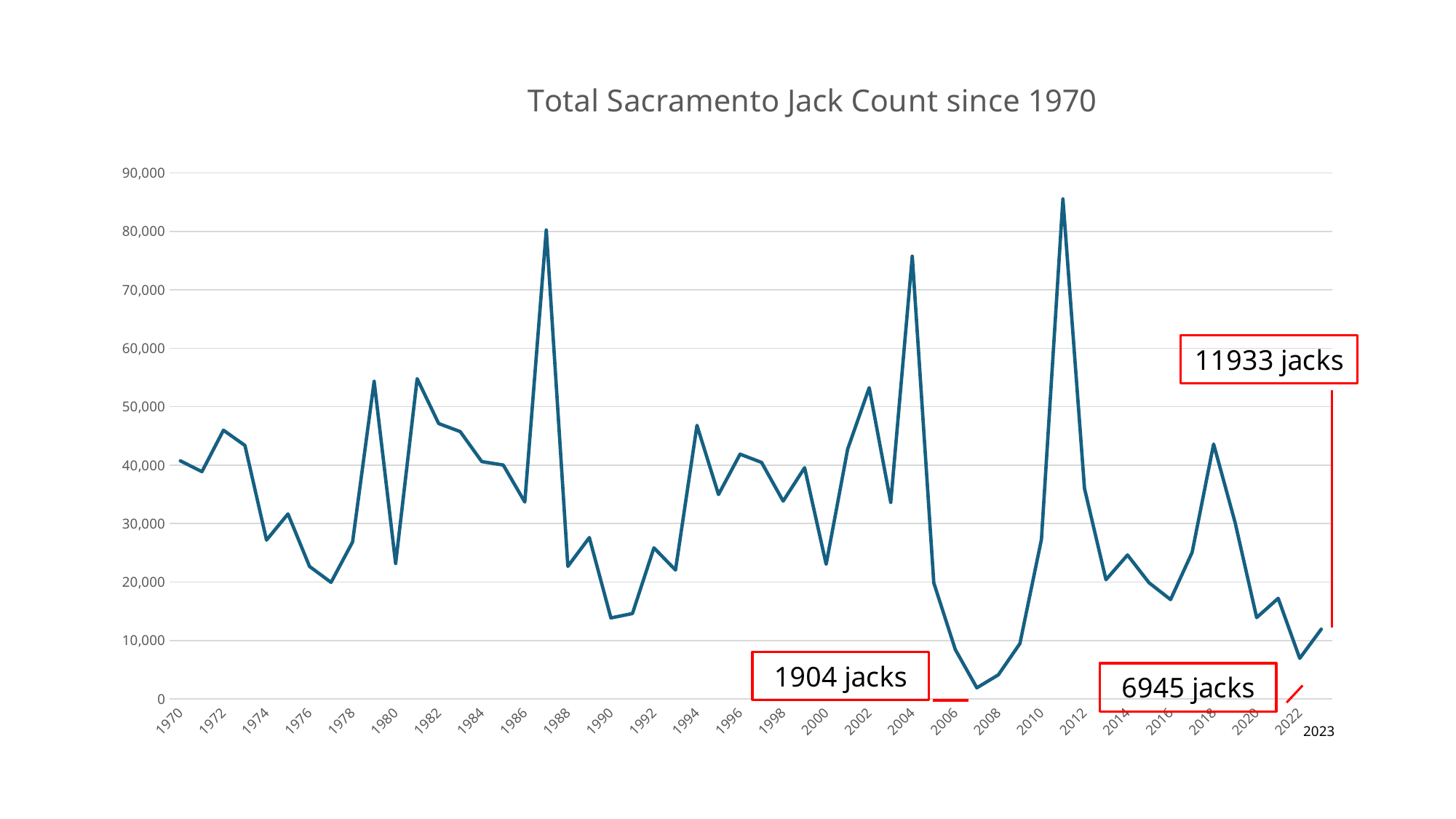
Is the value for 1979 greater or less than 50,000? greater Is the highest value on the chart greater or less than 80,000? greater What is the title of the chart? Total Sacramento Jack Count since 1970 Is the value for 2018 greater or less than 40,000? greater What value is labeled for 2023 on the chart? 11933 jacks What is the difference between the labeled 2023 value and the labeled 2022 value? 4988 jacks What value is labeled for 2022 on the chart? 6945 jacks What kind of chart is shown on the slide? line chart Which is larger, the labeled value for 2022 or for 2023? 2023 What value is labeled at the lowest point of the line? 1904 jacks Does the line rise or fall from 2018 to 2022? fall